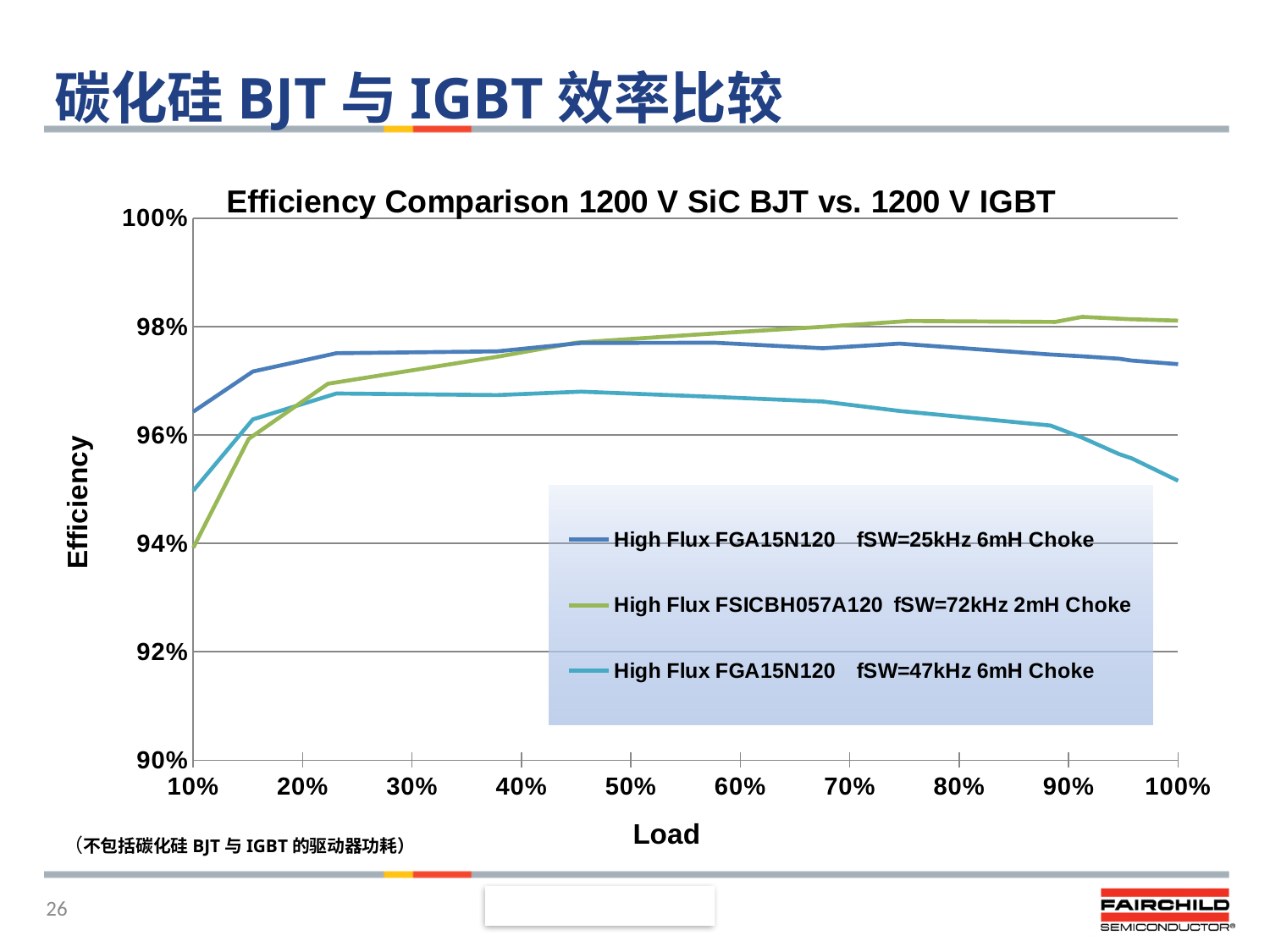
How many load values are labelled on the x axis? 10 Is the efficiency of the High Flux FGA15N120 fSW=25kHz 6mH Choke series at 10% load greater or less than 96%? greater Is the efficiency of the High Flux FGA15N120 fSW=25kHz 6mH Choke series at 100% load greater or less than 98%? less How many series does the legend list? 3 What kind of chart is shown on the slide? line chart At 10% load, which series has the higher efficiency: High Flux FGA15N120 fSW=25kHz 6mH Choke or High Flux FSICBH057A120 fSW=72kHz 2mH Choke? High Flux FGA15N120 fSW=25kHz 6mH Choke What is the title of the chart? Efficiency Comparison 1200 V SiC BJT vs. 1200 V IGBT Which series has the lowest efficiency at 10% load? High Flux FSICBH057A120 fSW=72kHz 2mH Choke Is the efficiency of the High Flux FGA15N120 fSW=47kHz 6mH Choke series at 100% load greater or less than 96%? less What is the label of the vertical axis? Efficiency Which series has the highest efficiency at 100% load? High Flux FSICBH057A120 fSW=72kHz 2mH Choke Does the efficiency of the High Flux FGA15N120 fSW=47kHz 6mH Choke series rise or fall between 50% and 100% load? fall